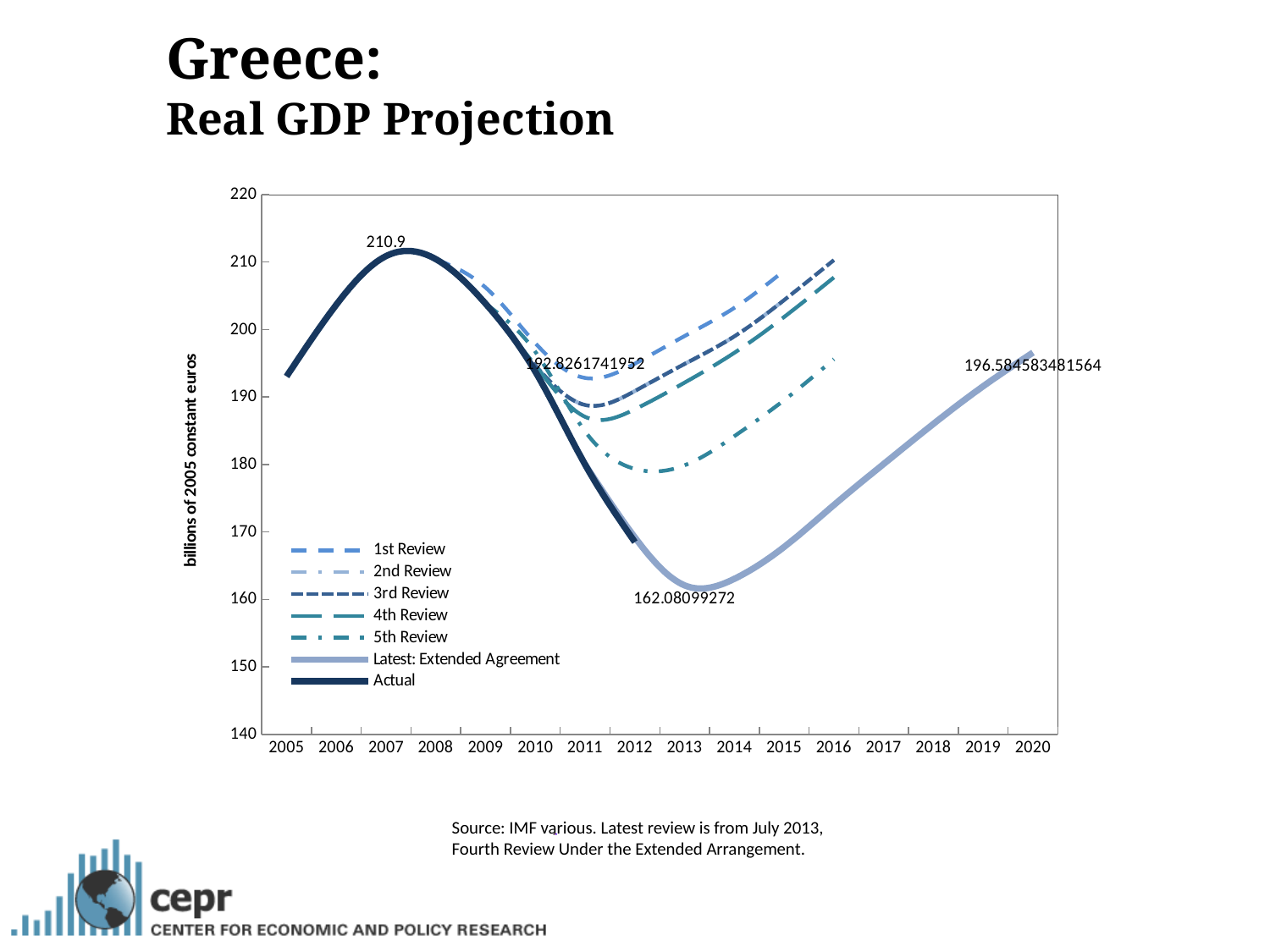
How many series does the legend list? 7 What is the peak value labeled on the Actual series? 210.9 What value is labeled for the Latest: Extended Agreement series in 2020? 196.584583481564 Is the value of the 1st Review series in 2015 greater or less than 200? greater In 2015, which is higher: the 1st Review series or the 5th Review series? 1st Review What is the difference between the labeled peak of 210.9 and the labeled trough of 162.08099272? 48.81900728 What is the label on the vertical axis? billions of 2005 constant euros What kind of chart is shown on the slide? line chart Is the value of the Actual series in 2005 greater or less than 200? less Does the Latest: Extended Agreement series rise or fall from 2013 to 2020? rise Is the value of the Actual series in 2012 greater or less than 180? less What is the lowest value labeled on the Latest: Extended Agreement series? 162.08099272